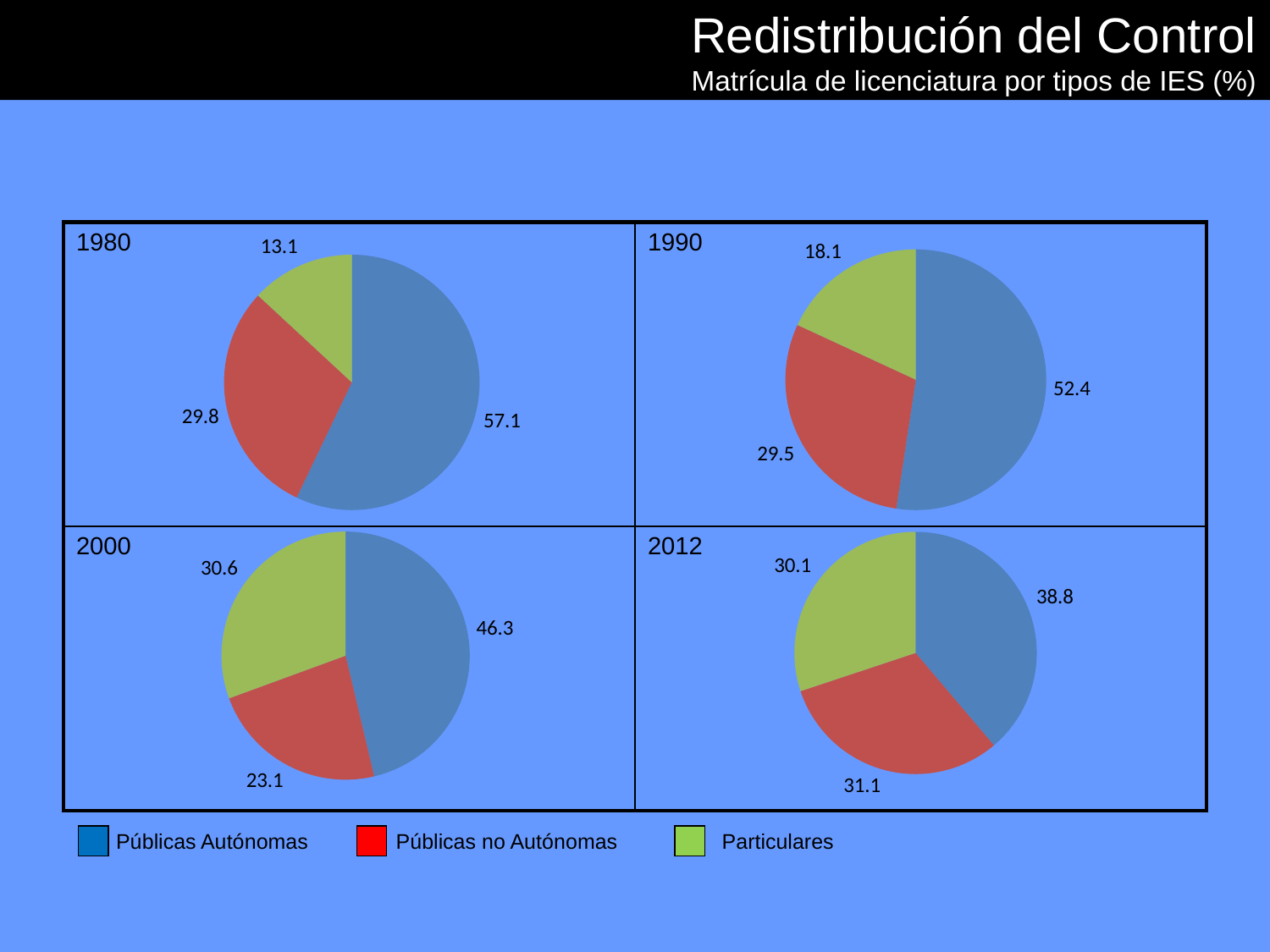
In the 2012 pie chart, what is the value for Públicas Autónomas? 38.8 In the 1990 pie chart, what is the value for Particulares? 18.1 In the 2000 pie chart, which category has the largest slice? Públicas Autónomas In the 1990 pie chart, what is the difference between the Públicas Autónomas value and the Públicas no Autónomas value? 22.9 In the 1980 pie chart, what is the value for Públicas Autónomas? 57.1 What type of chart is used for each year on the slide? Pie chart In the 1980 pie chart, which category has the smallest slice? Particulares In the 2000 pie chart, which is larger: Particulares or Públicas no Autónomas? Particulares In the 2000 pie chart, what is the value for Públicas no Autónomas? 23.1 How many pie charts are shown on the slide? 4 How many categories does the legend list? 3 How does the Públicas Autónomas value change across the four pie charts from 1980 to 2012? It falls